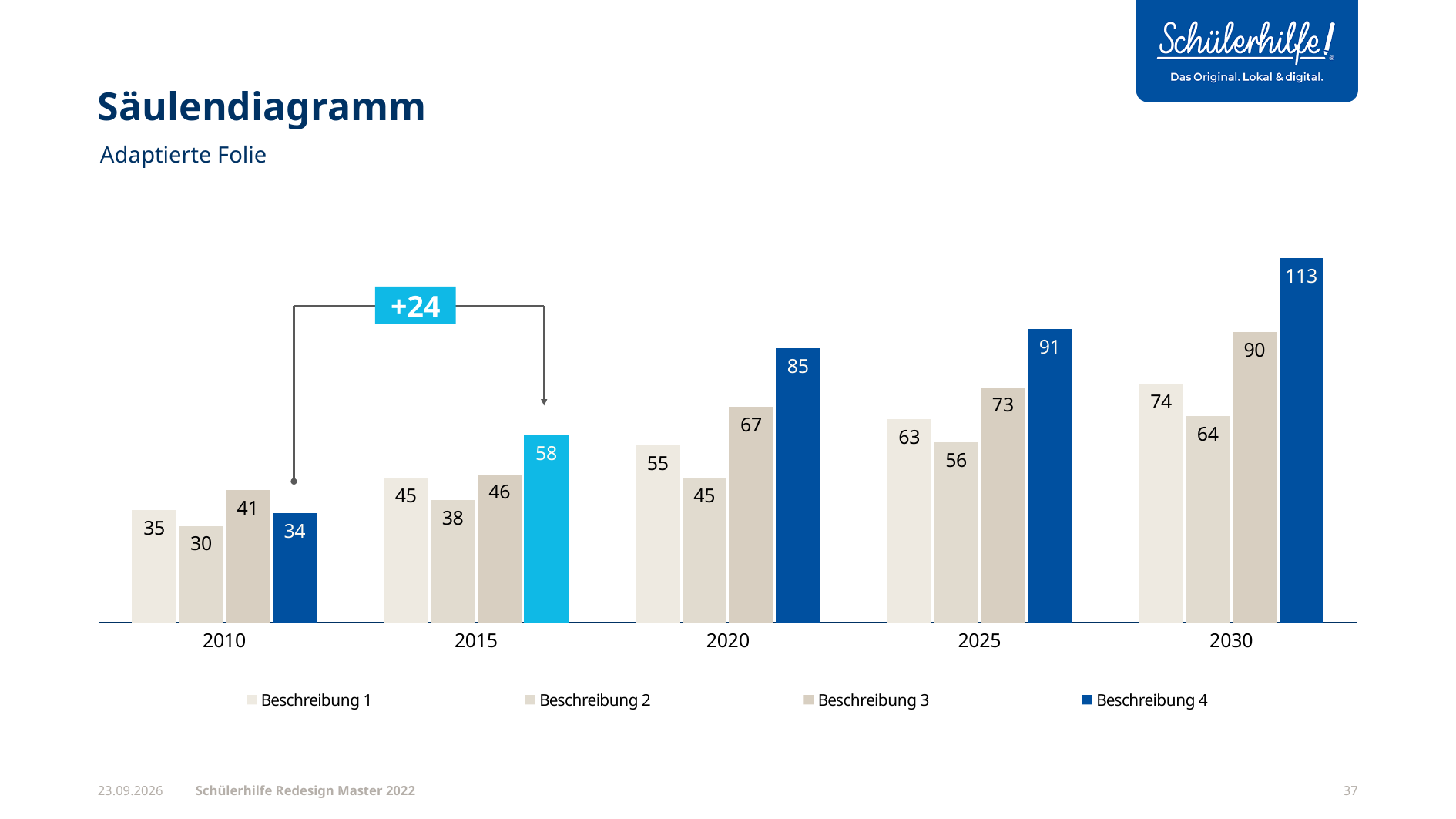
How many series does the legend list? 4 What is the value for Beschreibung 3 in 2015? 46 What is the difference between the Beschreibung 4 values for 2015 and 2010? 24 What is the value for Beschreibung 4 in 2010? 34 Which year has the highest value for Beschreibung 4? 2030 What value is shown in the callout box above the 2015 group? +24 Which year has the lowest value for Beschreibung 2? 2010 Do the values for Beschreibung 4 rise or fall from 2010 to 2030? Rise What kind of chart is shown on the slide? Bar chart Which is larger in 2030: Beschreibung 1 or Beschreibung 2? Beschreibung 1 What is the value for Beschreibung 2 in 2025? 56 How many years are shown on the x axis? 5